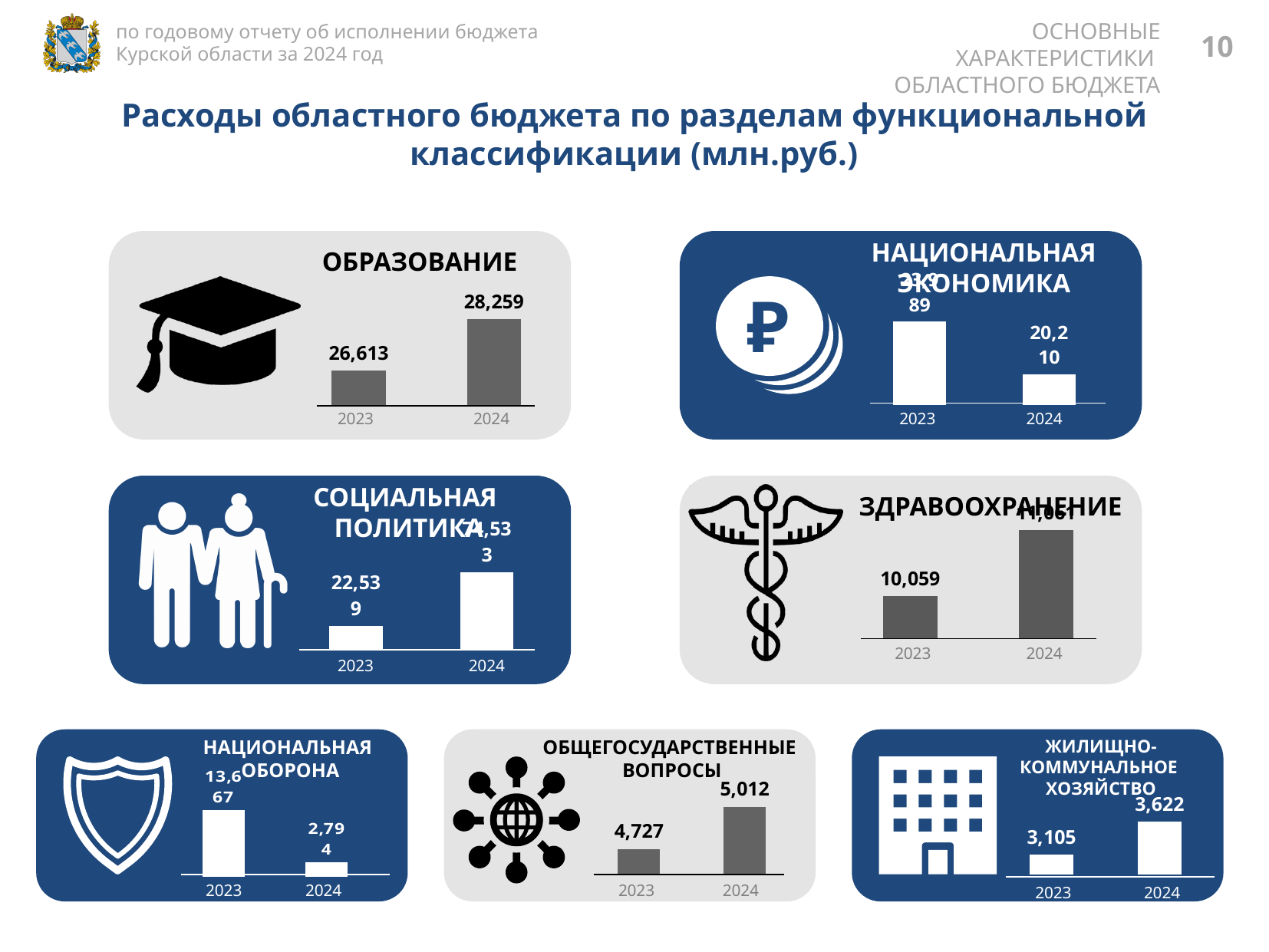
In the Образование chart, what is the difference between the 2024 and 2023 values? 1,646 In the Образование chart, what is the value for 2024? 28,259 In the Социальная политика chart, what is the value for 2023? 22,539 What kind of chart is used in the Общегосударственные вопросы panel? bar chart How many categories (years) does the Жилищно-коммунальное хозяйство chart show? 2 In the Общегосударственные вопросы chart, what is the difference between the 2024 and 2023 values? 285 In the Национальная экономика chart, which year has the larger value, 2023 or 2024? 2023 In the Национальная оборона chart, what is the value for 2024? 2,794 In the Здравоохранение chart, do the values rise or fall from 2023 to 2024? rise In the Образование chart, what is the value for 2023? 26,613 In the Здравоохранение chart, what is the value for 2023? 10,059 In the Жилищно-коммунальное хозяйство chart, what is the value for 2024? 3,622